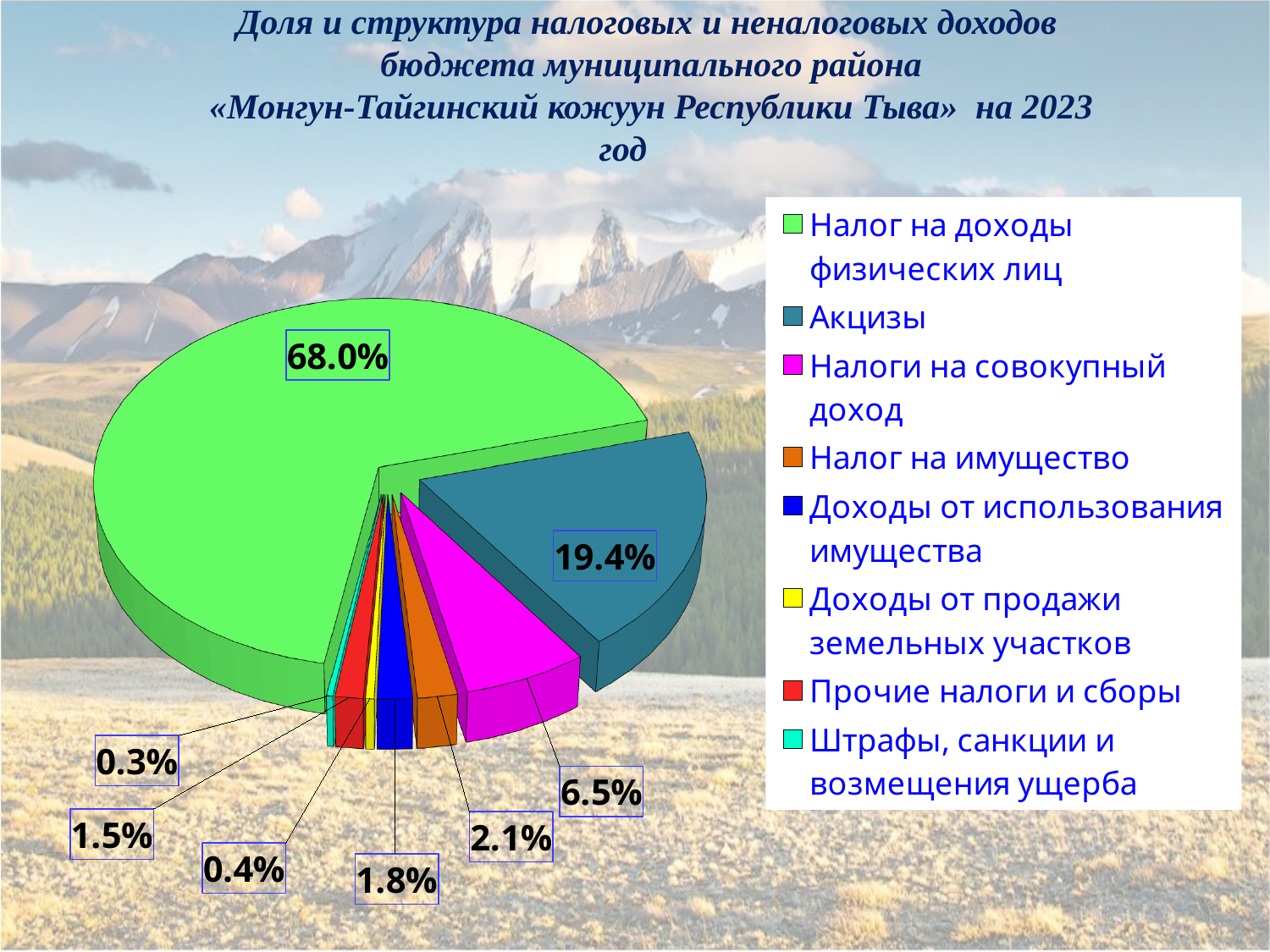
What is the value shown for "Налоги на совокупный доход"? 6.5% What is the difference between the shares of "Налог на доходы физических лиц" and "Акцизы"? 48.6% What is the value shown for "Налог на имущество"? 2.1% What is the value shown for "Штрафы, санкции и возмещения ущерба"? 0.3% Which category has the smallest share of the pie? Штрафы, санкции и возмещения ущерба How many categories does the legend list? 8 What is the value shown for "Доходы от использования имущества"? 1.8% What share of the pie does "Налог на доходы физических лиц" have? 68.0% Which category has the largest share of the pie? Налог на доходы физических лиц Which is larger, the share for "Прочие налоги и сборы" or for "Доходы от продажи земельных участков"? Прочие налоги и сборы What is the value shown for "Акцизы"? 19.4% What kind of chart is shown on the slide? pie chart